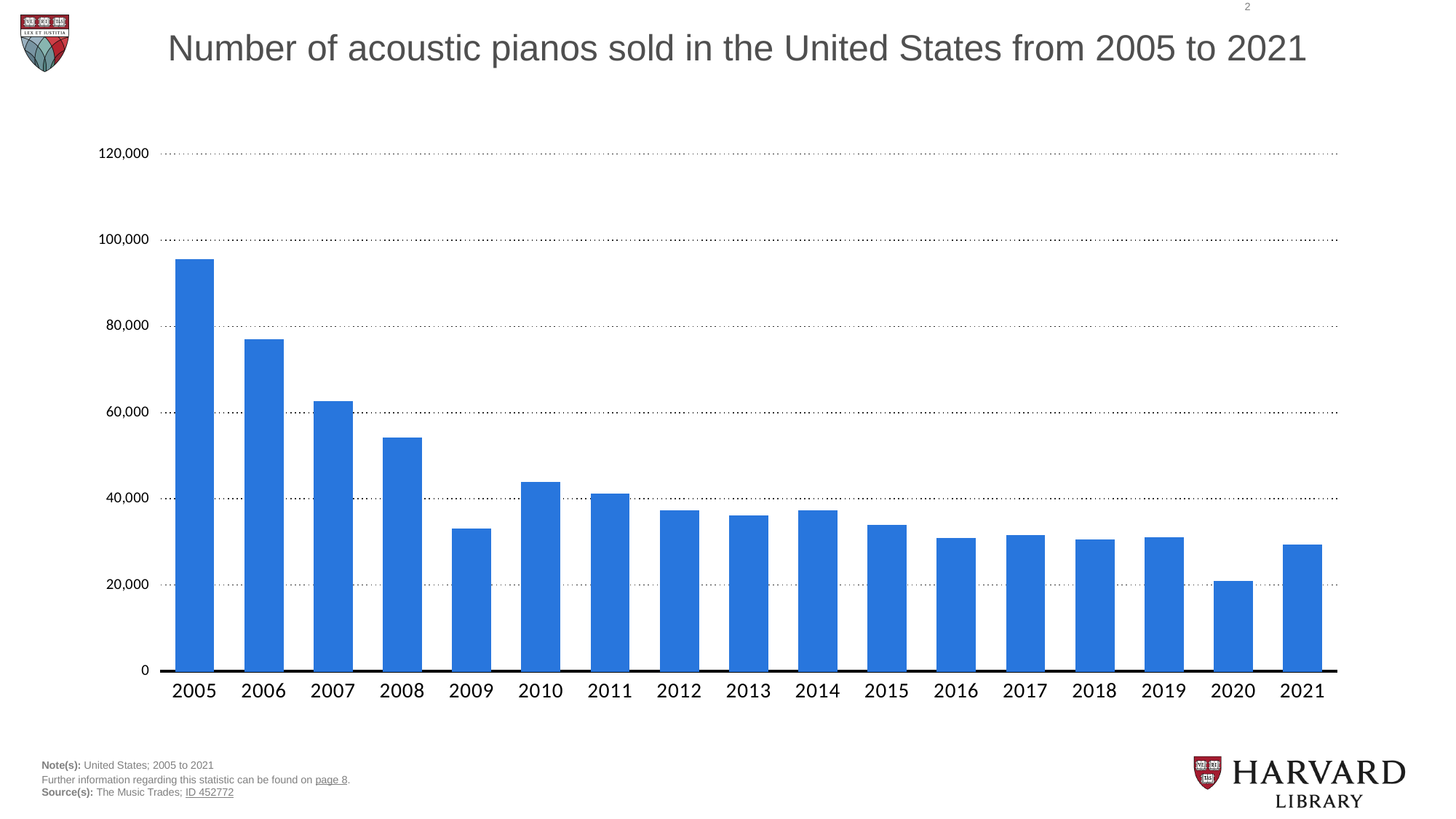
Is the value for 2010 greater or less than 40,000? greater Do the values generally rise or fall from 2005 to 2021? fall Which is larger, the value for 2009 or the value for 2010? 2010 Which year has the lowest number of acoustic pianos sold? 2020 Is the value for 2008 greater or less than 60,000? less What kind of chart is shown on the slide? bar chart Is the value for 2005 greater or less than 80,000? greater Which year has the highest number of acoustic pianos sold? 2005 How many years are shown on the x axis? 17 What is the title of the chart? Number of acoustic pianos sold in the United States from 2005 to 2021 Which is larger, the value for 2007 or the value for 2010? 2007